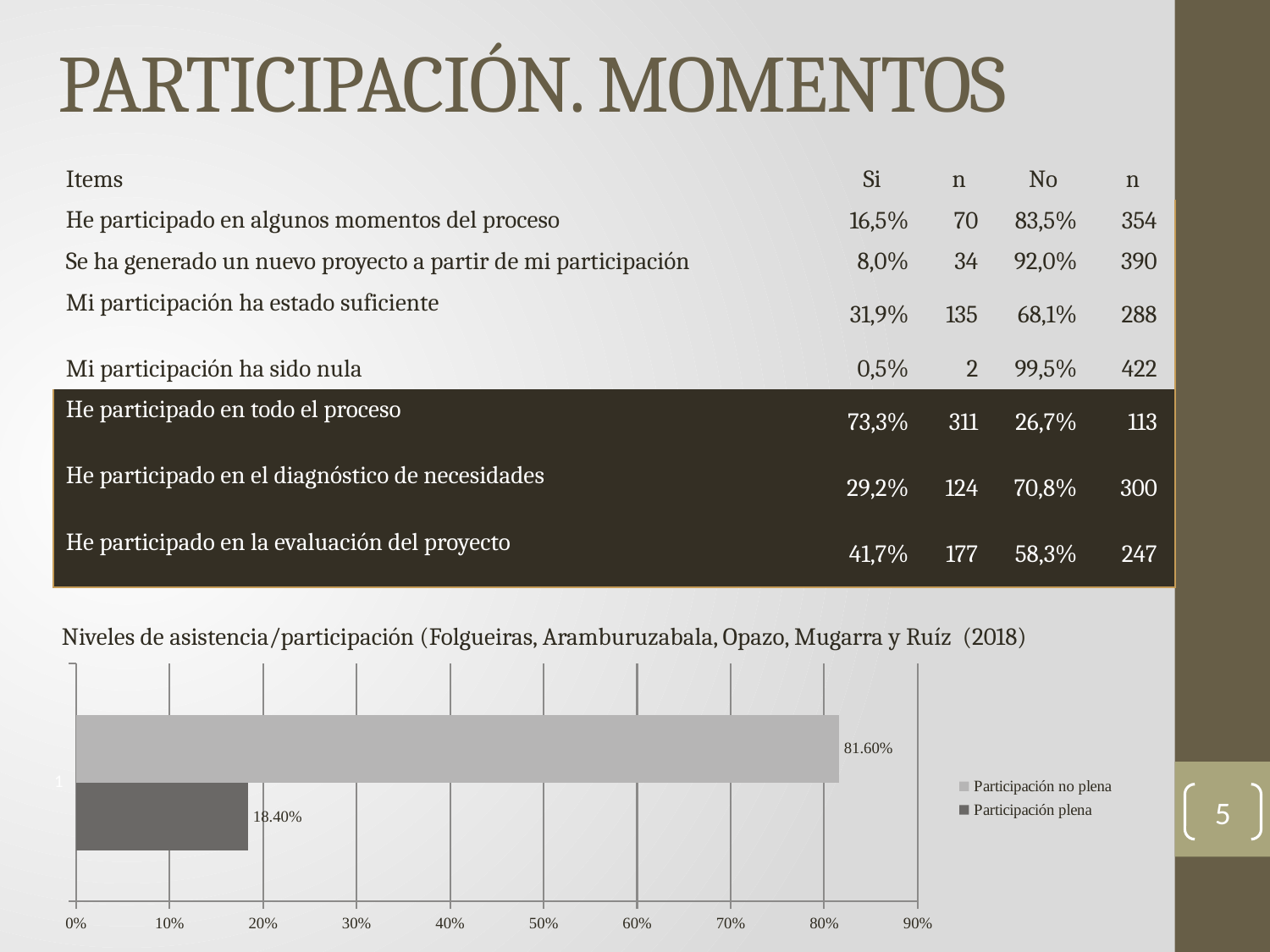
Is the value for Participación no plena greater or less than 80%? greater Which series has the higher value, Participación no plena or Participación plena? Participación no plena How many categories are plotted on the vertical axis of the chart? 1 What kind of chart is shown at the bottom of the slide? bar chart Which series has the lowest value in the chart? Participación plena Is the value for Participación plena greater or less than 20%? less How many series does the chart legend list? 2 What is the highest value labelled on the horizontal axis of the chart? 90% Which legend entry is shown in the darker grey colour? Participación plena What is the value shown for Participación plena? 18.40% What is the value shown for Participación no plena? 81.60% What is the difference between the values for Participación no plena and Participación plena? 63.20%